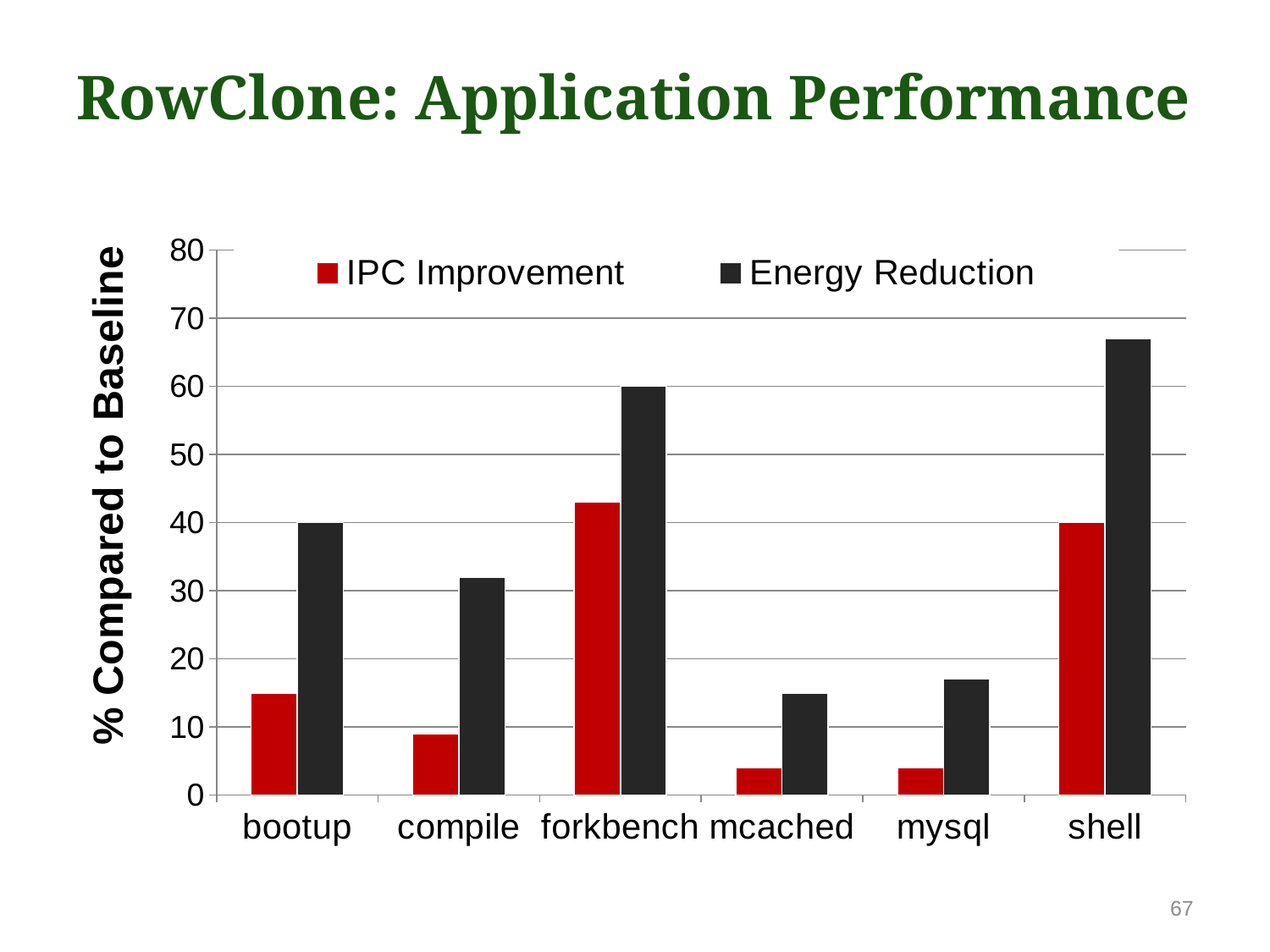
Is the Energy Reduction for mysql greater or less than 20? less What type of chart is shown on the slide? bar chart Which is larger: the Energy Reduction for bootup or the Energy Reduction for compile? bootup How many series does the chart's legend list? 2 Is the IPC Improvement for forkbench greater or less than 40? greater How many applications are shown on the x axis of the chart? 6 Is the IPC Improvement for compile greater or less than 10? less Which is larger for mcached: IPC Improvement or Energy Reduction? Energy Reduction What is the label of the y axis of the chart? % Compared to Baseline Which application has the highest IPC Improvement? forkbench Which application has the highest Energy Reduction? shell